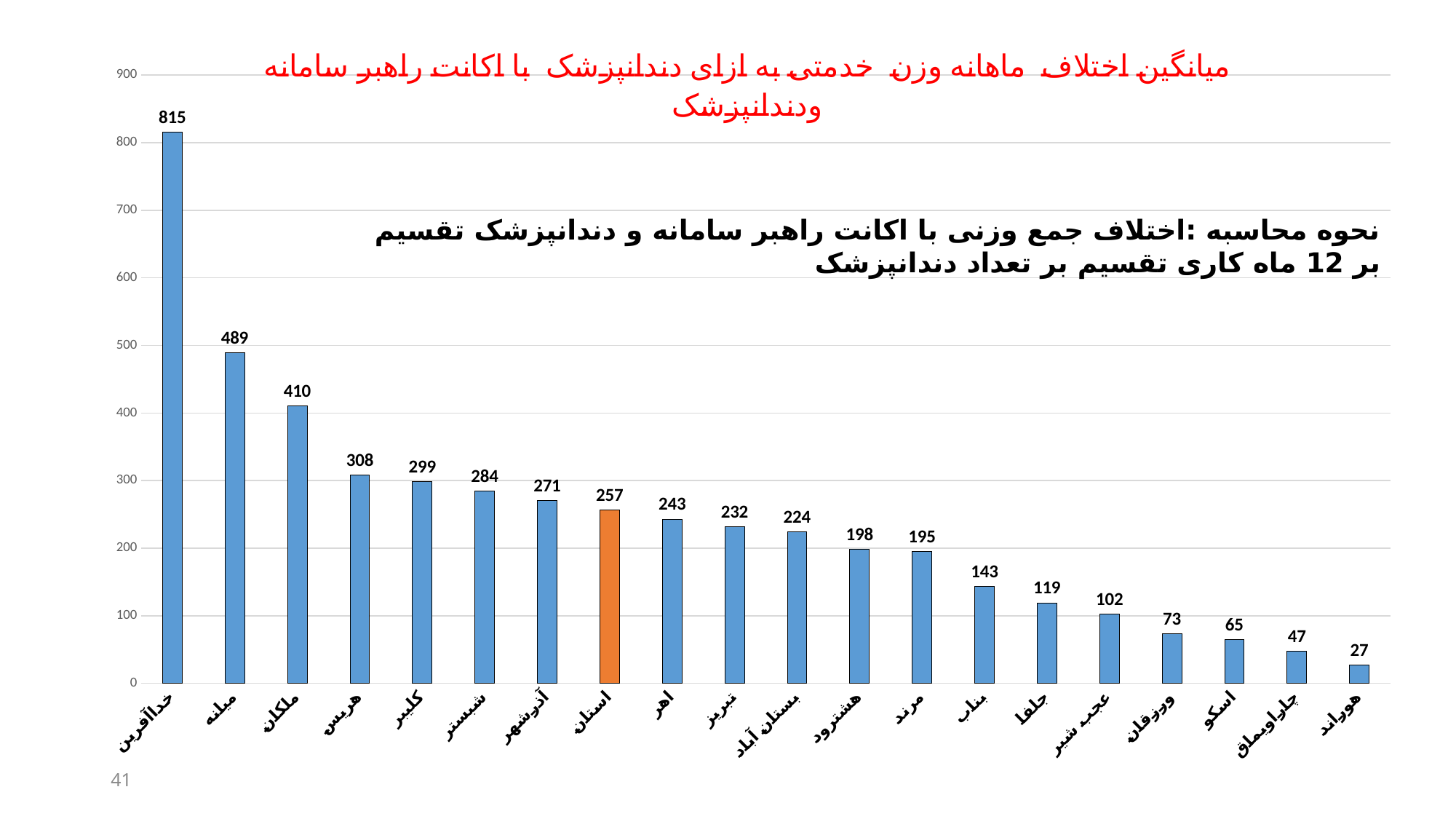
Which is larger, the value for اهر or the value for مرند? اهر What is the value for استان? 257 Do the values rise or fall from left to right along the x axis? fall What is the value for هوراند? 27 Which category has the lowest value? هوراند Which bar is coloured orange instead of blue? استان What is the difference between the values for میانه and ملکان? 79 What is the value for خداآفرین? 815 Which category has the highest value? خداآفرین How many categories are shown on the x axis? 20 What is the value for تبریز? 232 What type of chart is shown on the slide? bar chart